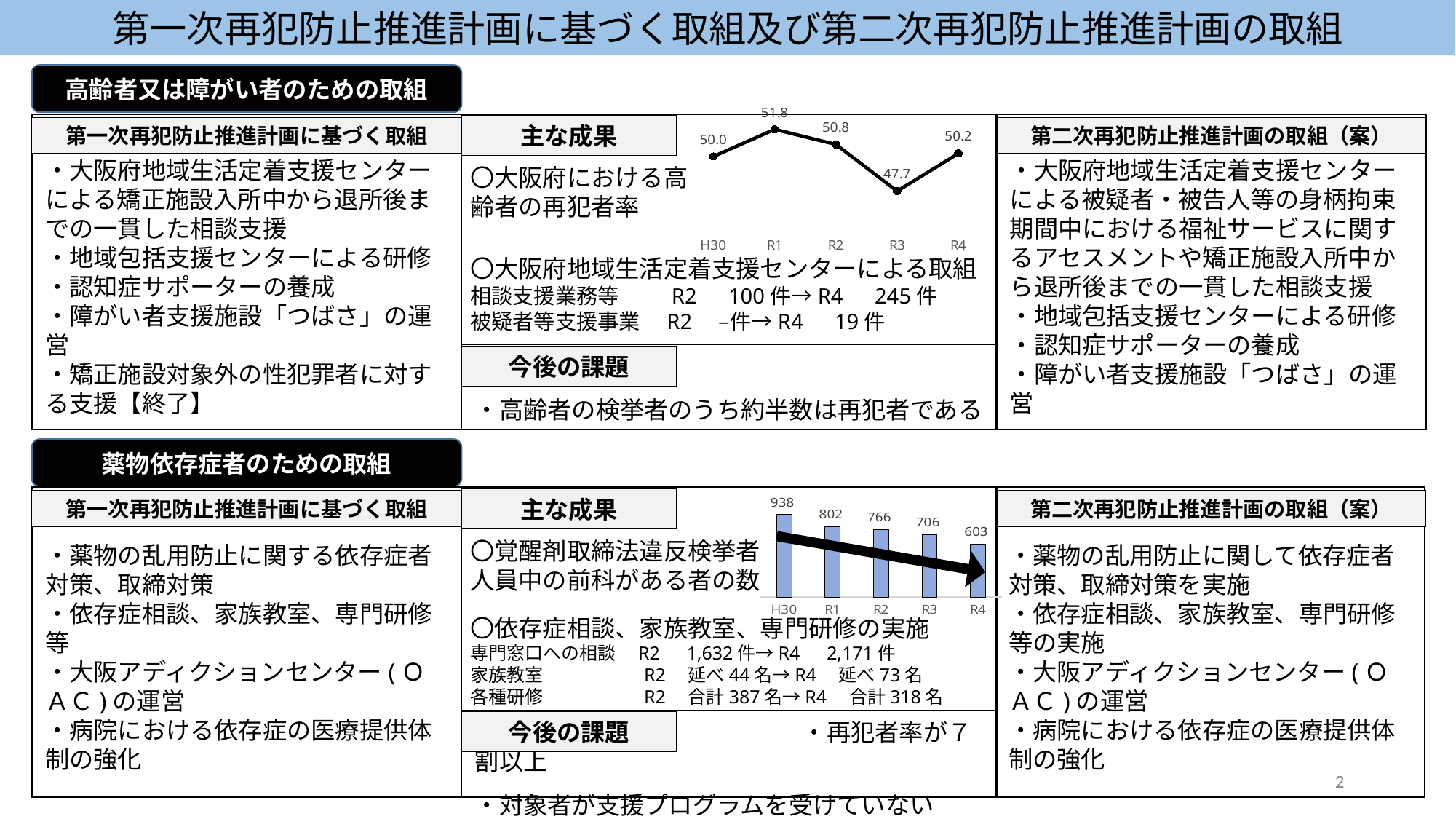
In the top line chart, what is the difference between the R1 value and the R3 value? 4.1 In the bottom bar chart, what is the value for R4? 603 What kind of chart is the top chart? line chart In the bottom bar chart, what is the difference between the H30 value and the R4 value? 335 In the top line chart, how many data points are plotted? 5 In the top line chart, which year has the lowest value? R3 In the bottom bar chart, do the values rise or fall from H30 to R4? fall In the top line chart, which year has the highest value? R1 What kind of chart is the bottom chart? bar chart In the top line chart, what is the value for R3? 47.7 In the bottom bar chart, what is the value for H30? 938 In the top line chart, what is the value for R1? 51.8